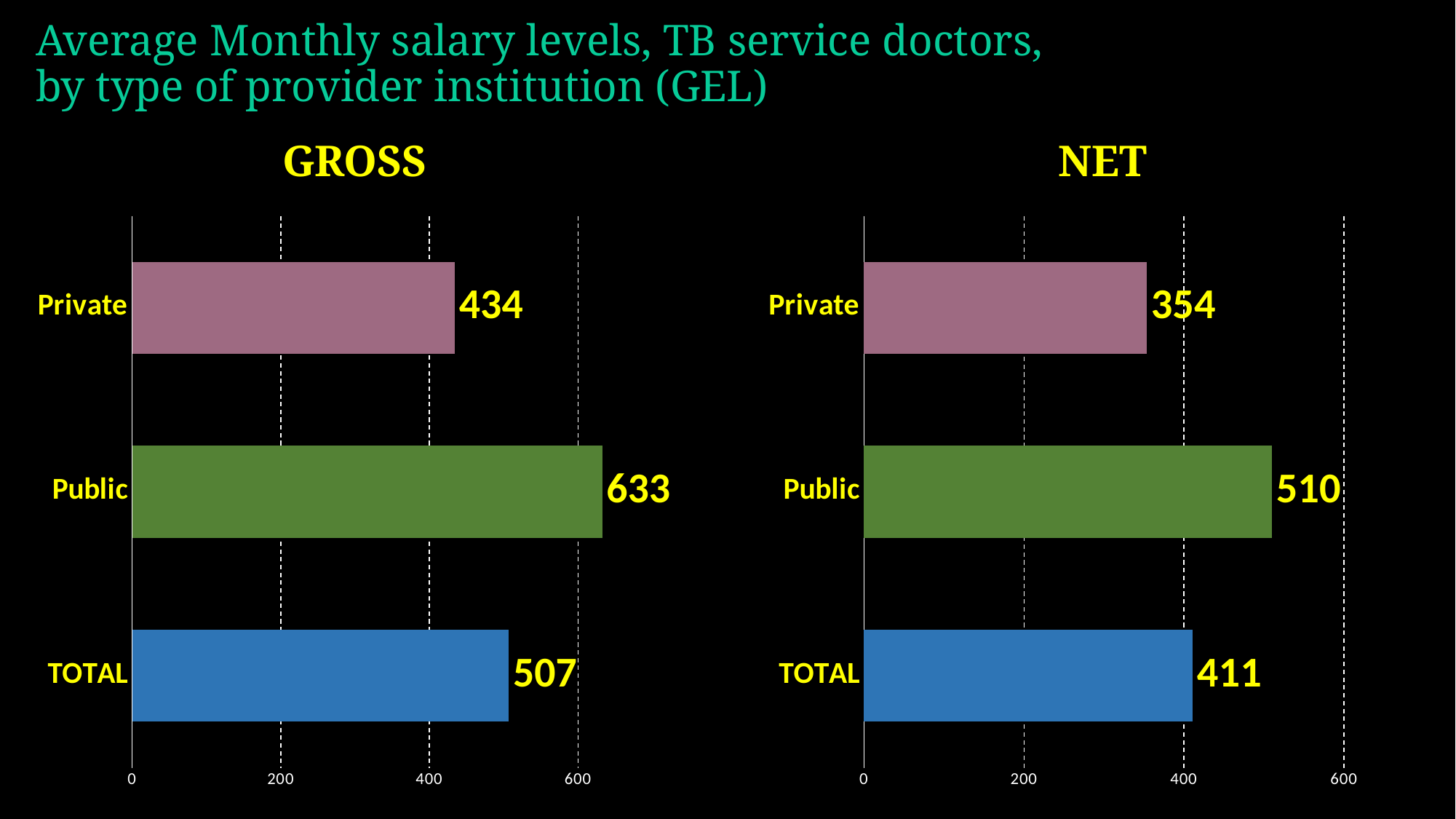
What kind of chart is the GROSS chart? bar chart In the GROSS chart, is the value for TOTAL greater or less than 400? greater In the GROSS chart, which category has the highest value? Public In the GROSS chart, what is the difference between the Public and Private values? 199 In the NET chart, which is larger, the value for Public or the value for TOTAL? Public In the NET chart, what is the difference between the Public and TOTAL values? 99 In the NET chart, which category has the lowest value? Private In the NET chart, what is the value for Private? 354 How many categories are shown in the NET chart? 3 In the GROSS chart, what is the value for Public? 633 In the GROSS chart, what is the value for Private? 434 In the NET chart, what is the value for TOTAL? 411